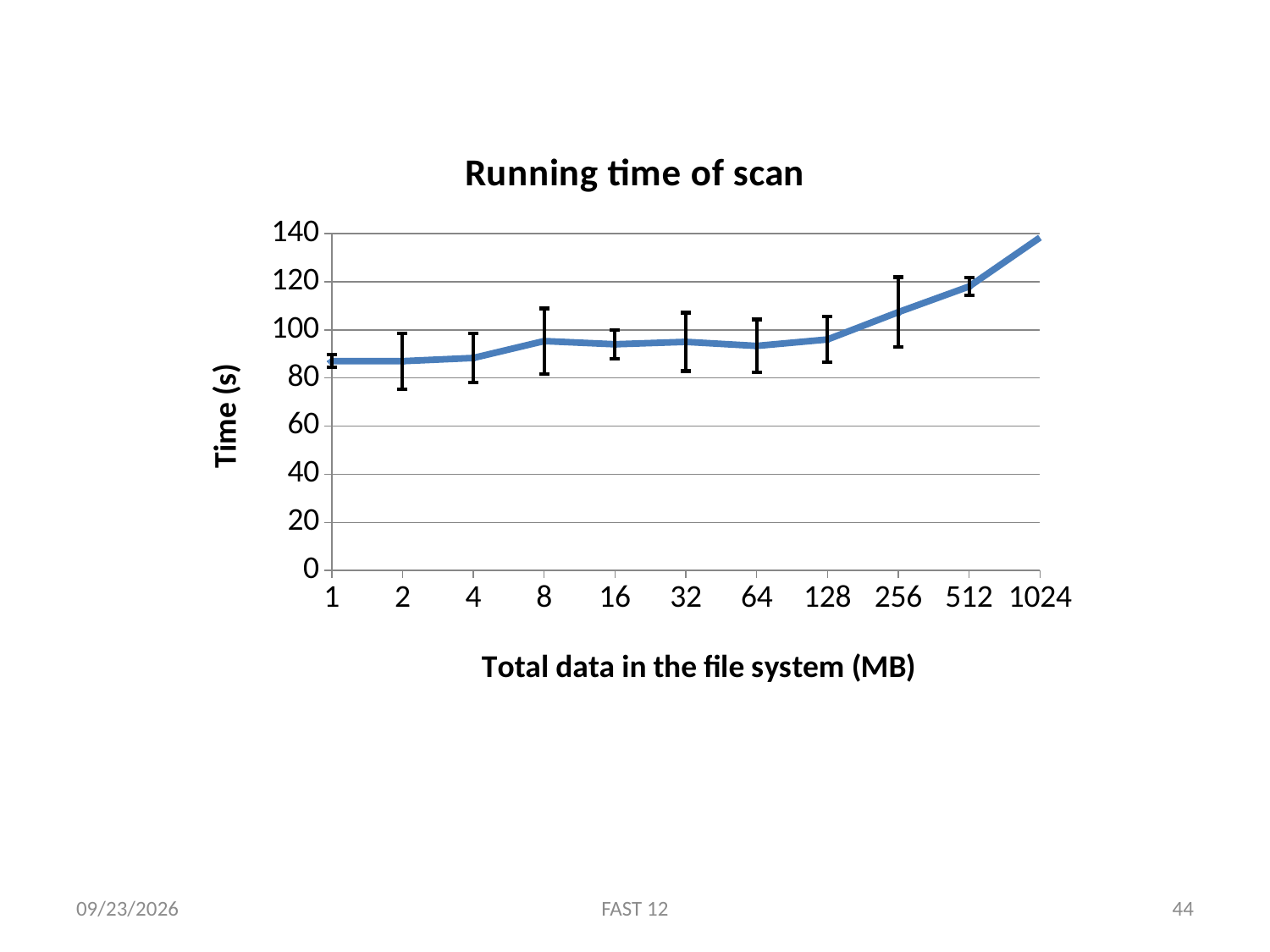
Does the running time generally rise or fall as the total data in the file system increases? rise Is the running time at 1024 MB greater or less than 120? greater What is the label of the y axis? Time (s) Is the running time at 1 MB greater or less than 100? less Which has the larger running time, 128 MB or 512 MB? 512 MB Which has the larger running time, 1 MB or 1024 MB? 1024 MB Is the running time at 512 MB greater or less than 100? greater What is the title of the chart? Running time of scan How many data points are plotted along the x axis? 11 What kind of chart is shown on the slide? line chart At which total data size is the running time highest? 1024